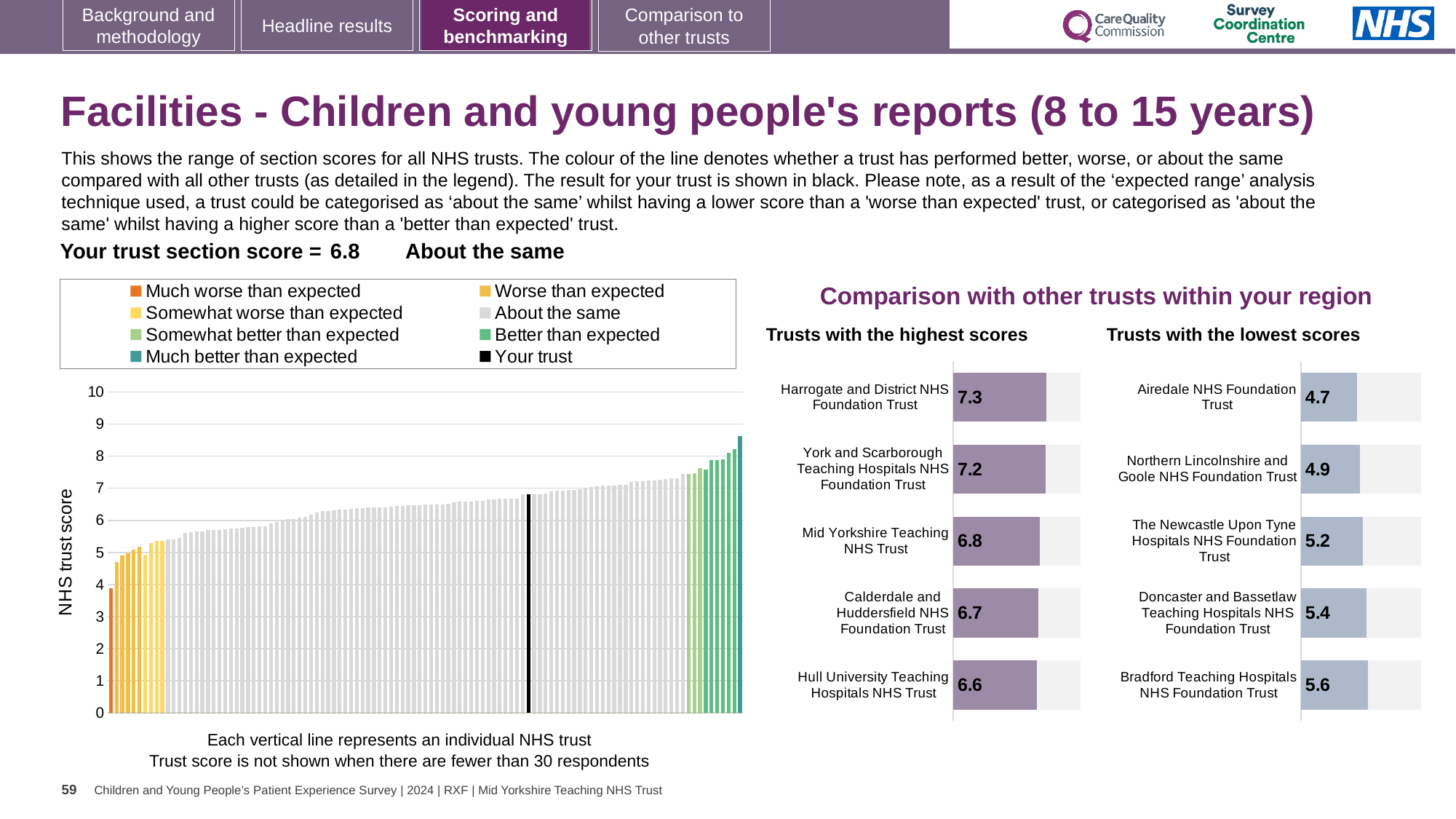
In the main 'NHS trust score' chart on the left, how many entries does the legend list? 8 In the main 'NHS trust score' chart on the left, is the value of the tallest bar (far right) greater or less than 8? greater In the 'Trusts with the lowest scores' chart, what is the difference between the scores of Bradford Teaching Hospitals NHS Foundation Trust and Airedale NHS Foundation Trust? 0.9 In the 'Trusts with the highest scores' chart, what is the difference between the scores of Harrogate and District NHS Foundation Trust and Hull University Teaching Hospitals NHS Trust? 0.7 In the 'Trusts with the highest scores' chart, what is the score for Harrogate and District NHS Foundation Trust? 7.3 In the 'Trusts with the highest scores' chart, which trust has the lowest score shown? Hull University Teaching Hospitals NHS Trust In the 'Trusts with the lowest scores' chart, which has the larger score: The Newcastle Upon Tyne Hospitals NHS Foundation Trust or Northern Lincolnshire and Goole NHS Foundation Trust? The Newcastle Upon Tyne Hospitals NHS Foundation Trust What kind of chart is the main 'NHS trust score' chart on the left? Bar chart In the 'Trusts with the lowest scores' chart, what is the score for Airedale NHS Foundation Trust? 4.7 In the 'Trusts with the lowest scores' chart, which trust has the highest score shown? Bradford Teaching Hospitals NHS Foundation Trust In the main 'NHS trust score' chart on the left, do the bar values rise or fall from left to right? Rise How many trusts are shown in the 'Trusts with the highest scores' chart? 5